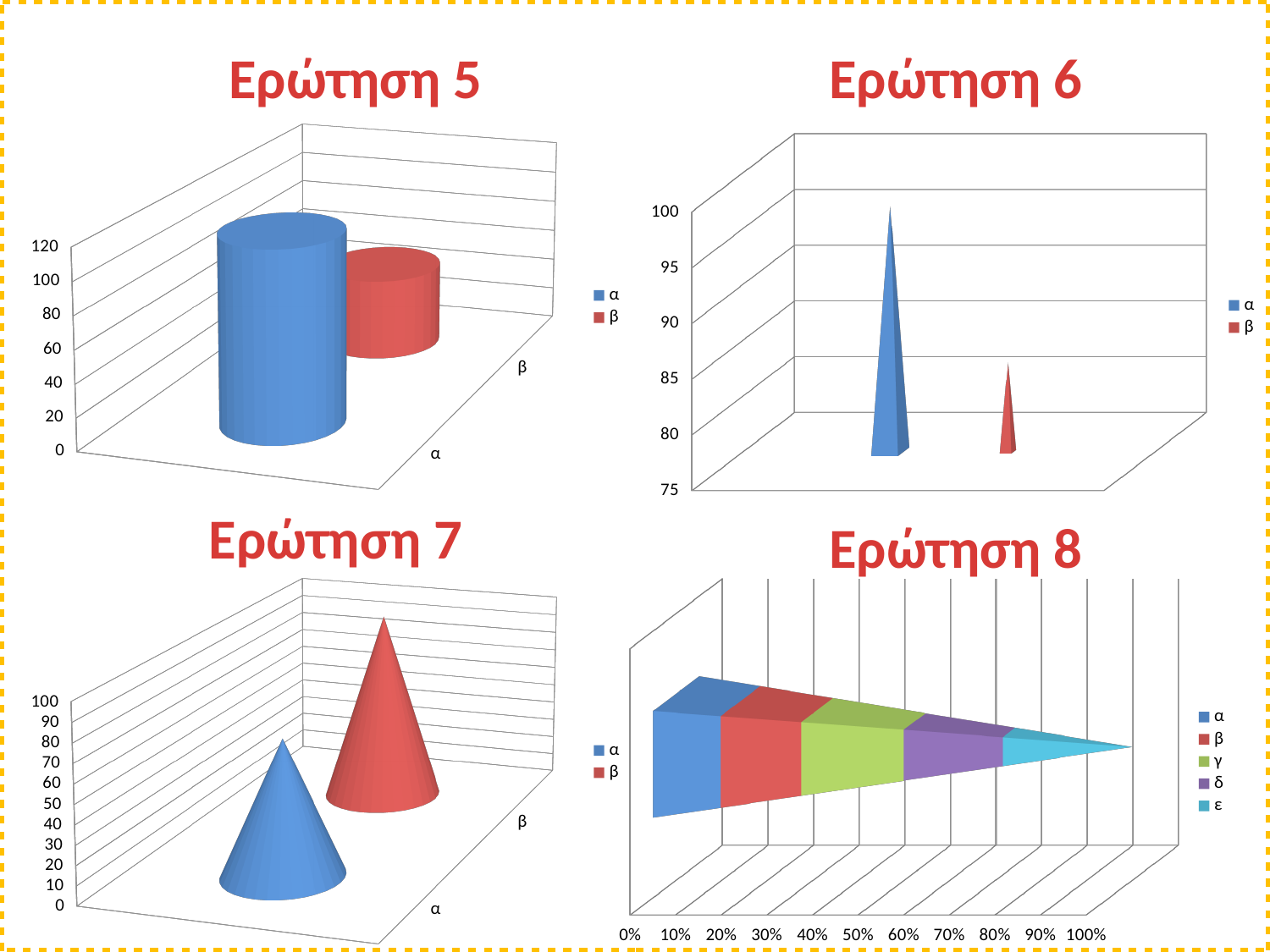
In the Ερώτηση 5 chart, how many categories are plotted? 2 In the Ερώτηση 7 chart, which category has the higher value, α or β? β In the Ερώτηση 6 chart, is the value for β greater or less than 95? less In the Ερώτηση 6 chart, which category has the higher value, α or β? α What kind of chart is the Ερώτηση 8 chart? Stacked bar chart In the Ερώτηση 7 chart, is the value for β greater or less than 70? greater In the Ερώτηση 8 chart, how many series does the legend list? 5 In the Ερώτηση 7 chart, is the value for α greater or less than 90? less In the Ερώτηση 6 chart, how many series does the legend list? 2 In the Ερώτηση 8 chart, which colour represents series γ? Green In the Ερώτηση 5 chart, which category has the larger value, α or β? α In the Ερώτηση 5 chart, what is the highest value shown on the vertical axis? 120